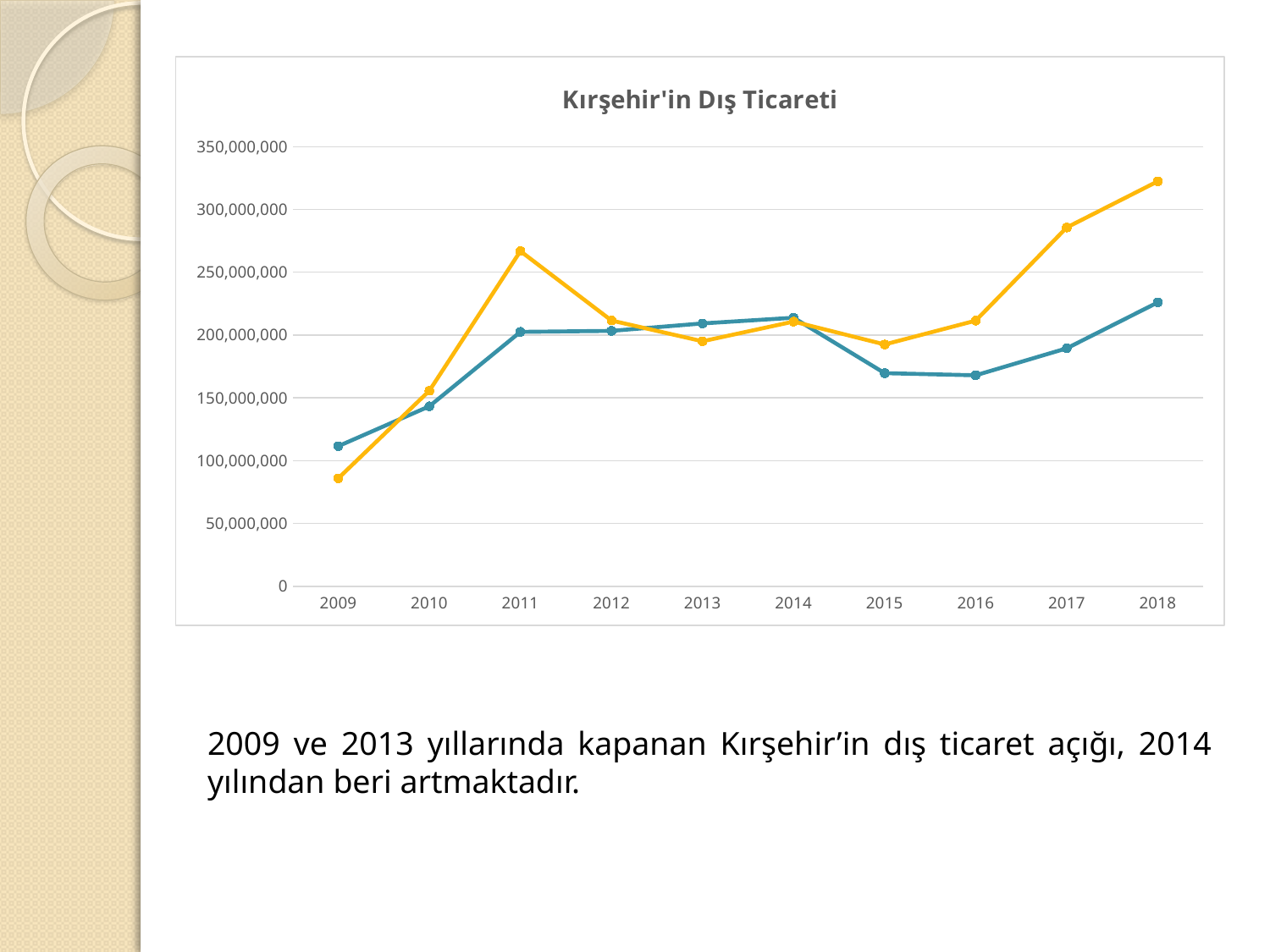
What kind of chart is shown on the slide? line chart In 2011, which line has the higher value, the orange line or the teal line? orange line Does the teal line rise or fall from 2016 to 2018? rise In which year does the teal line reach its highest value? 2018 Is the value of the teal line in 2009 greater or less than 150,000,000? less In which year does the orange line reach its highest value? 2018 In 2015, which line has the higher value, the orange line or the teal line? orange line Is the value of the orange line in 2018 greater or less than 300,000,000? greater In which year does the orange line have its lowest value? 2009 What is the title of the chart? Kırşehir'in Dış Ticareti Is the value of the orange line in 2011 greater or less than 250,000,000? greater How many years are shown on the x axis of the chart? 10